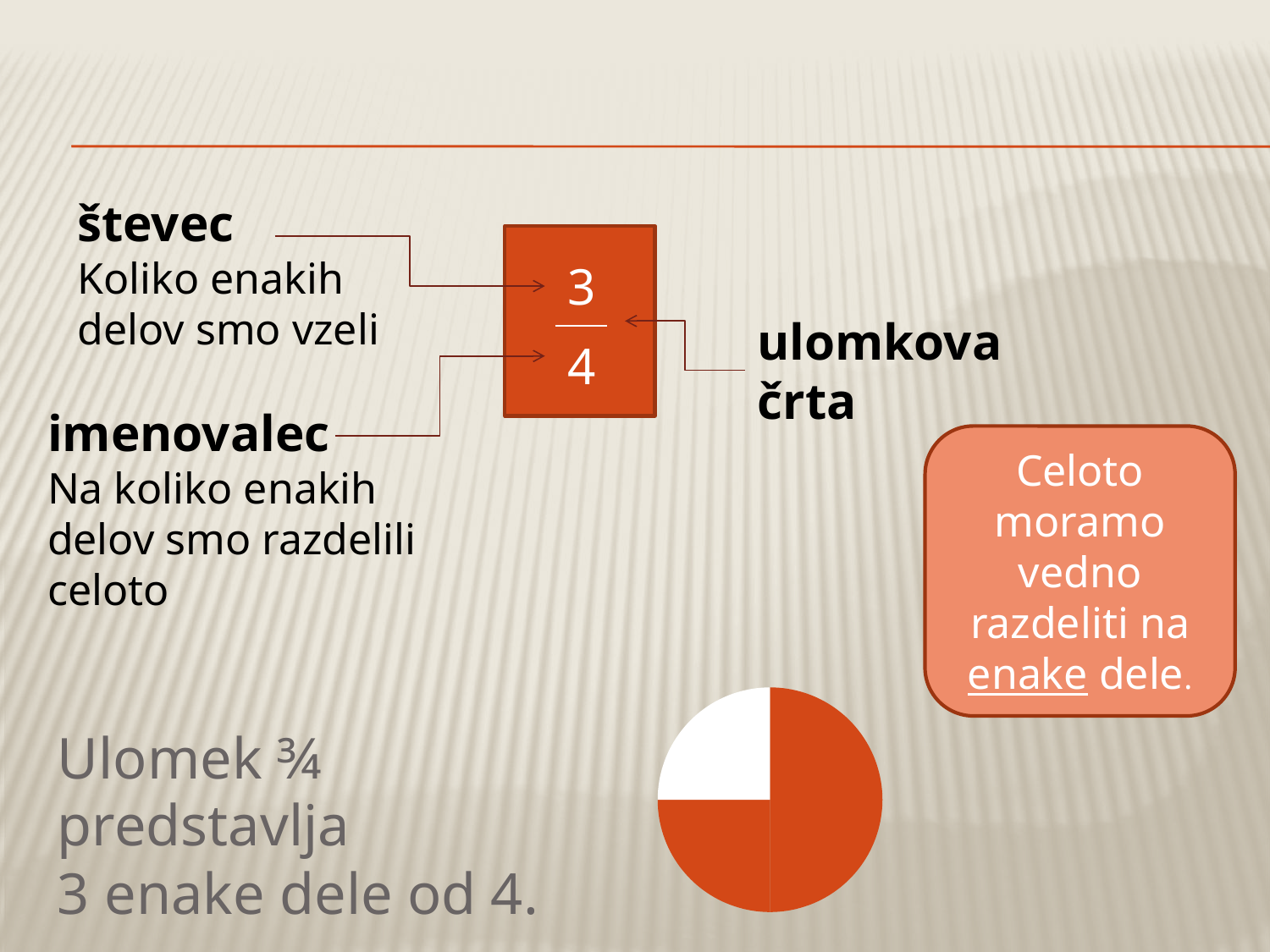
Which colour covers the larger part of the pie chart, orange or white? orange How many equal slices is the pie chart divided into? 4 Which fraction does the pie chart illustrate, according to the slide? ¾ How many slices of the pie chart are white? 1 How many slices of the pie chart are coloured orange? 3 Does the pie chart have a legend? No What kind of chart is shown at the bottom of the slide? pie chart What fraction of the pie chart is shaded orange? ¾